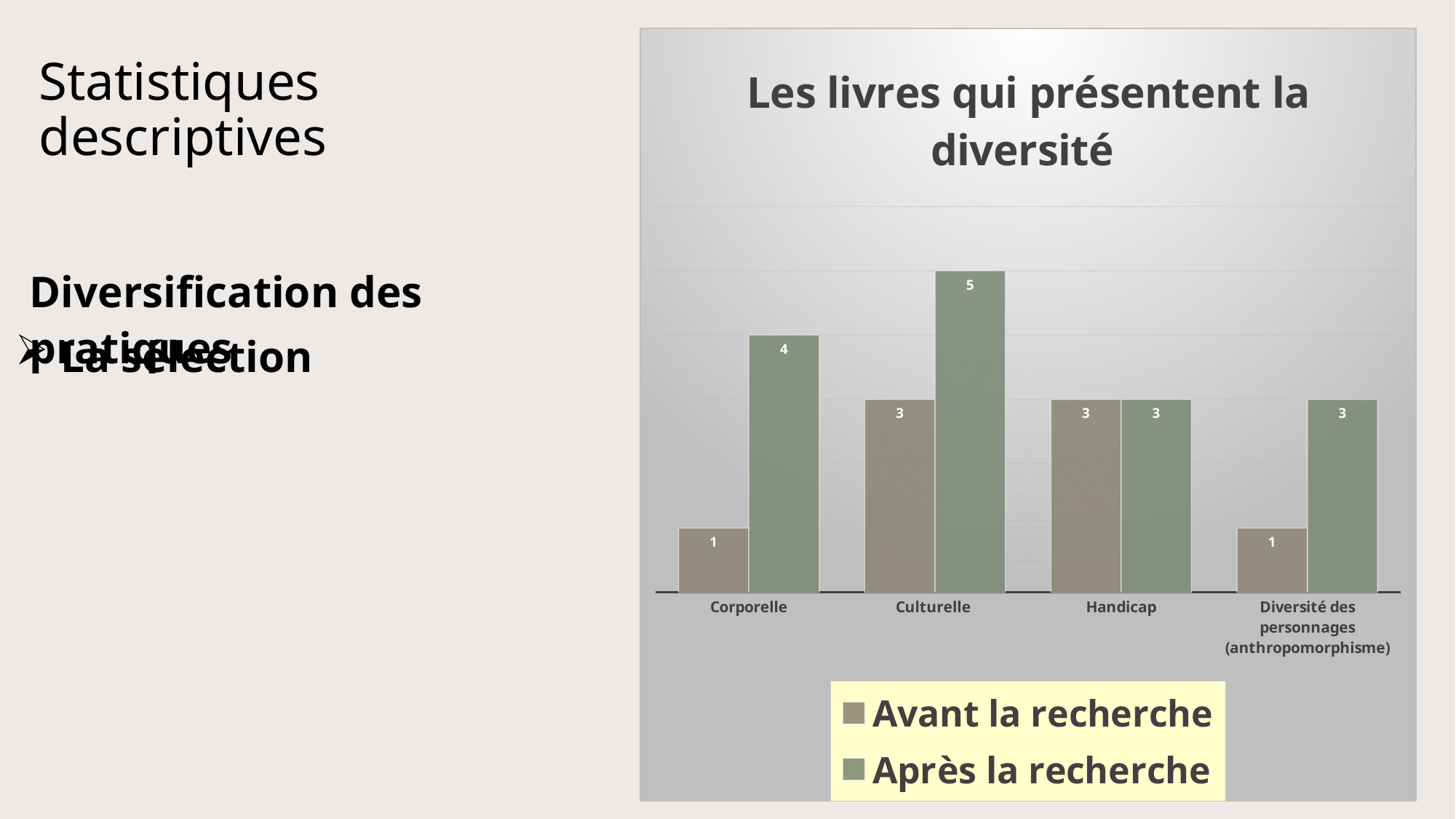
What kind of chart is shown on the slide? Bar chart Which is larger for Culturelle: Avant la recherche or Après la recherche? Après la recherche Which category has the highest value in the Après la recherche series? Culturelle What is the value for Handicap in the Avant la recherche series? 3 How many categories are shown on the x axis? 4 What is the value for Culturelle in the Après la recherche series? 5 Which category has the highest value in the Avant la recherche series? Culturelle and Handicap (both 3) What is the value for Corporelle in the Avant la recherche series? 1 What is the difference between the Après la recherche and Avant la recherche values for Corporelle? 3 What is the value for Diversité des personnages (anthropomorphisme) in the Après la recherche series? 3 What is the title of the chart? Les livres qui présentent la diversité How many series does the legend list? 2